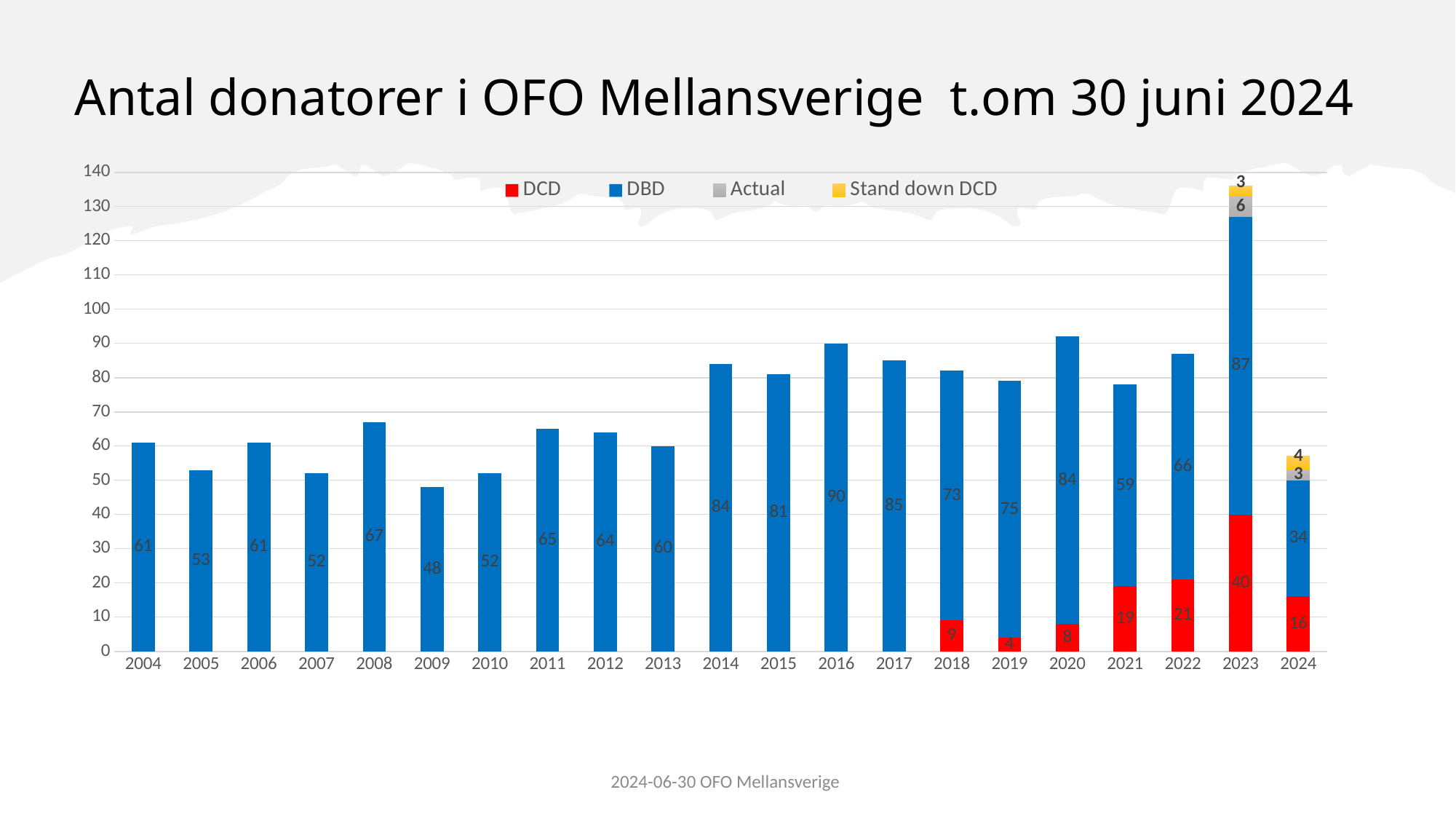
Which year has the lowest DBD value? 2024 What is the DCD value for 2022? 21 Which year has the highest DCD value? 2023 What is the total of the stacked bar for 2023? 136 How many years are shown on the x axis? 21 How many series does the legend list? 4 What is the Actual value for 2023? 6 Is the DBD value for 2014 larger than the DBD value for 2015? Yes What is the Stand down DCD value for 2024? 4 What is the difference between the DBD values for 2016 and 2009? 42 What is the DBD value for 2016? 90 What kind of chart is shown on the slide? Stacked bar chart